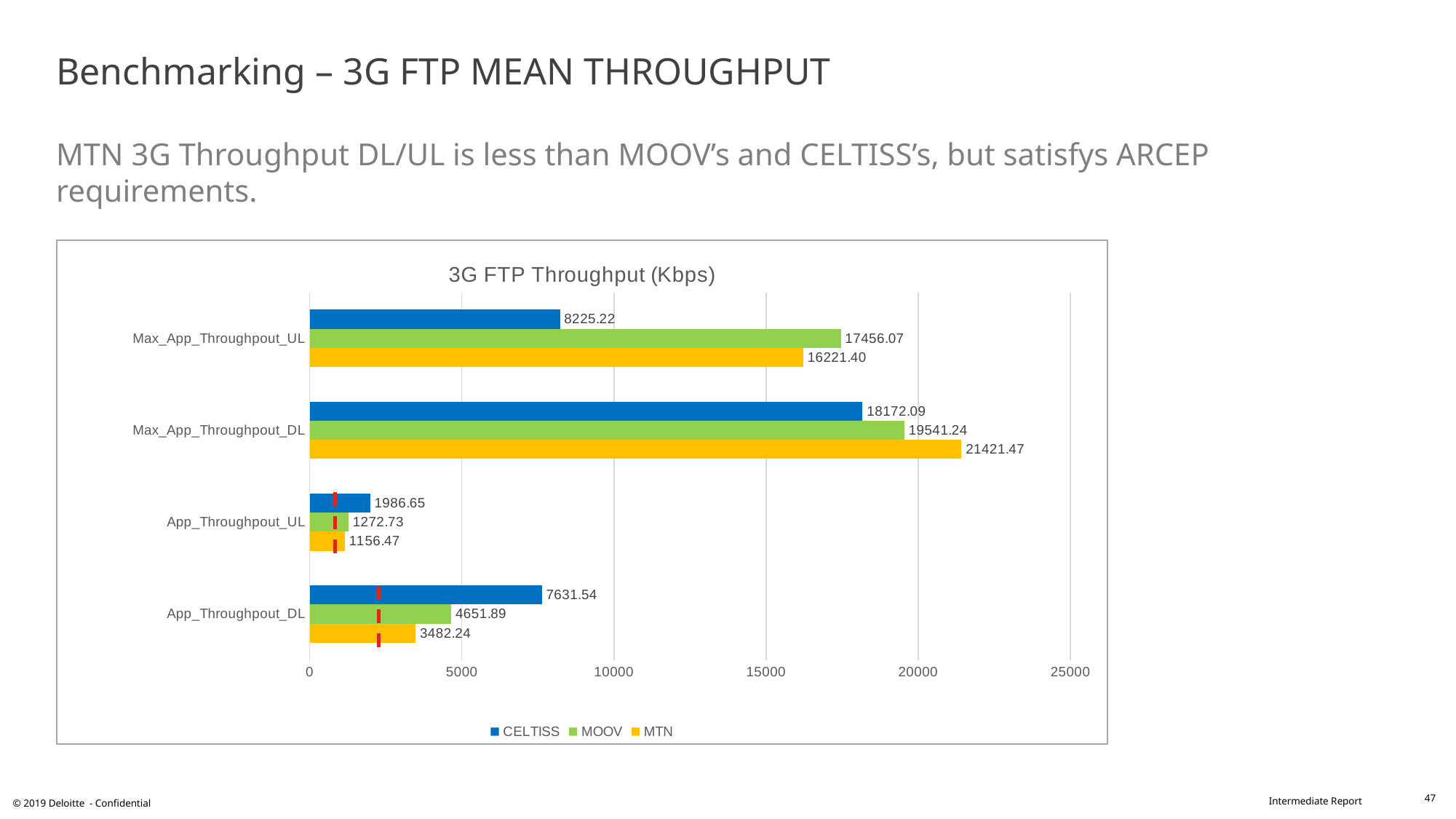
Which operator has the highest value for App_Throughpout_DL? CELTISS What is the MTN value for Max_App_Throughpout_DL? 21421.47 How many series does the legend list? 3 Is the MTN value for Max_App_Throughpout_UL greater or less than 15000? greater What is the difference between the MTN and CELTISS values for Max_App_Throughpout_DL? 3249.38 What is the MOOV value for Max_App_Throughpout_UL? 17456.07 Which operator has the lowest value for Max_App_Throughpout_UL? CELTISS What is the CELTISS value for App_Throughpout_UL? 1986.65 What is the difference between the CELTISS and MTN values for App_Throughpout_DL? 4149.30 How many categories are shown on the y axis of the chart? 4 What type of chart is shown on the slide? Bar chart Which is larger for Max_App_Throughpout_DL, the MOOV value or the CELTISS value? MOOV